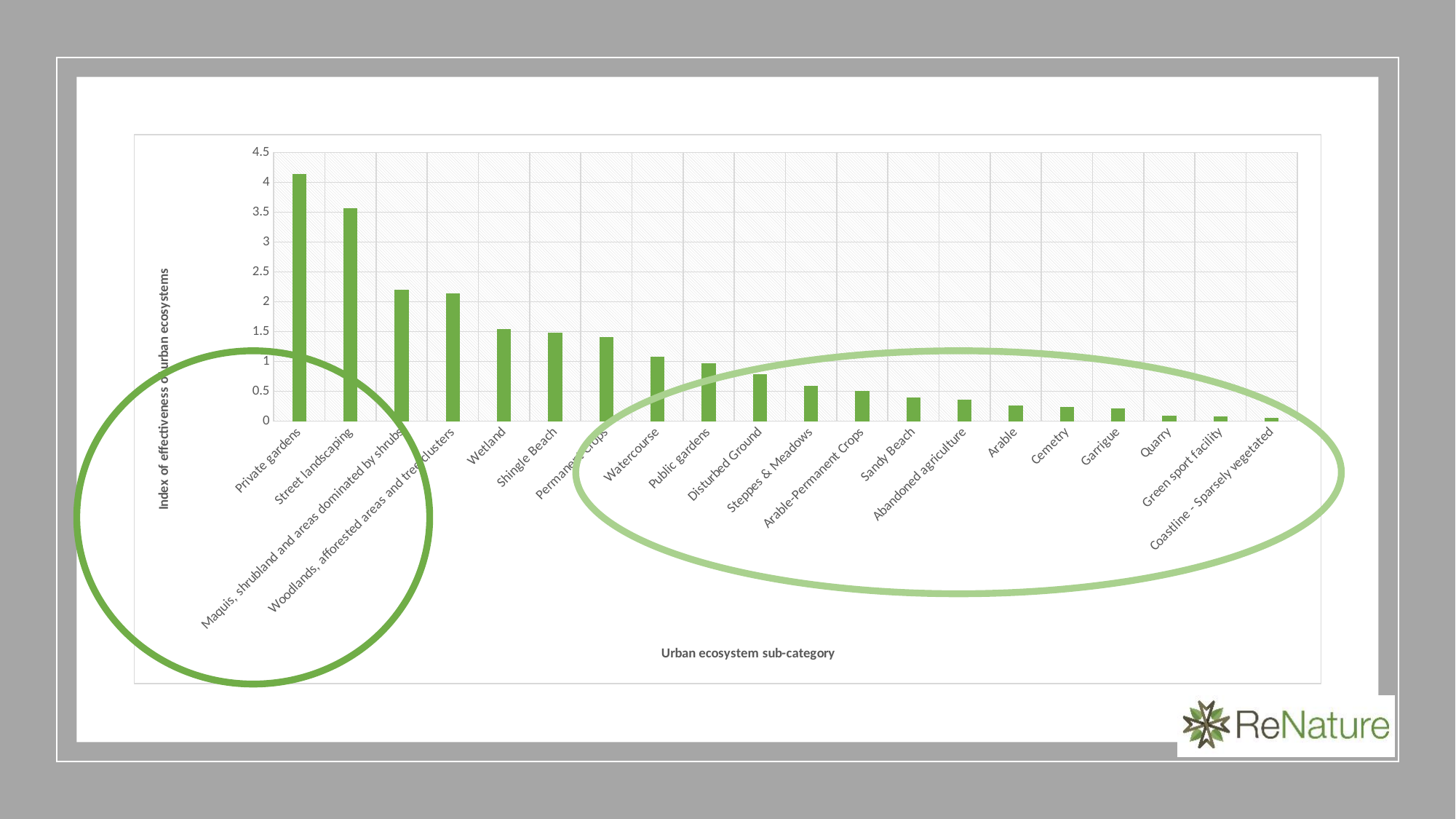
How many urban ecosystem sub-categories are plotted on the x axis? 20 Do the bar values rise or fall moving from left to right along the x axis? Fall Is the value for Arable greater or less than 0.5? less Which has a larger value, Watercourse or Sandy Beach? Watercourse What kind of chart is shown on the slide? Bar chart Which urban ecosystem sub-category has the highest index of effectiveness? Private gardens Is the value for Wetland greater or less than 1? greater What is the title of the vertical axis? Index of effectiveness of urban ecosystems Is the value for Street landscaping greater or less than 3? greater Which has a larger value, Private gardens or Street landscaping? Private gardens